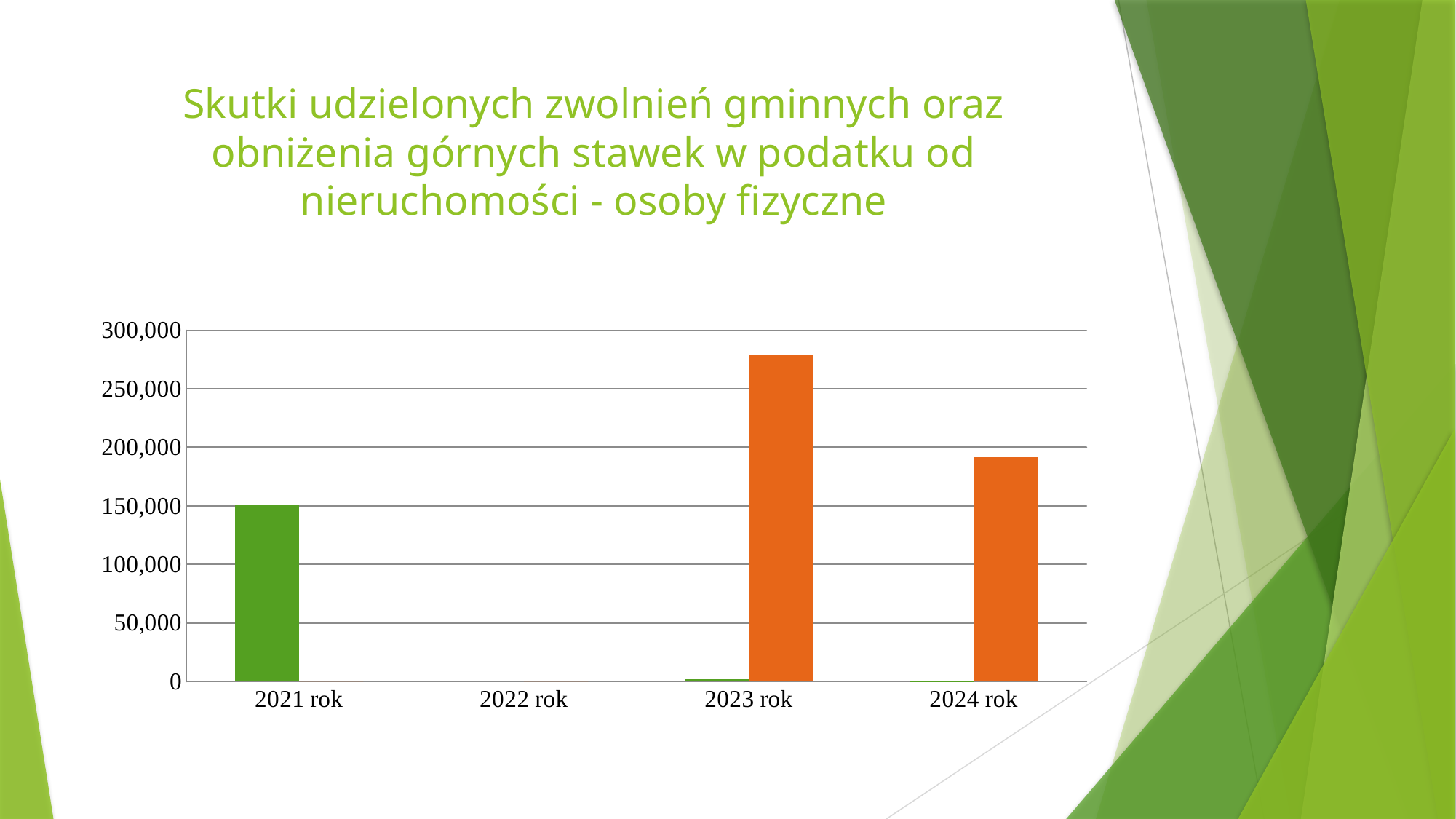
Which is larger, the green bar for 2021 rok or the orange bar for 2024 rok? 2024 rok What colour is the bar for 2021 rok? green How many year categories are shown on the x axis of the chart? 4 Which is larger, the orange bar for 2023 rok or the orange bar for 2024 rok? 2023 rok Is the value of the orange bar for 2024 rok greater or less than 200,000? less Is the value of the orange bar for 2023 rok greater or less than 250,000? greater Is the value of the green bar for 2021 rok greater or less than 200,000? less What kind of chart is shown on the slide? bar chart Which year has the highest bar in the chart? 2023 rok